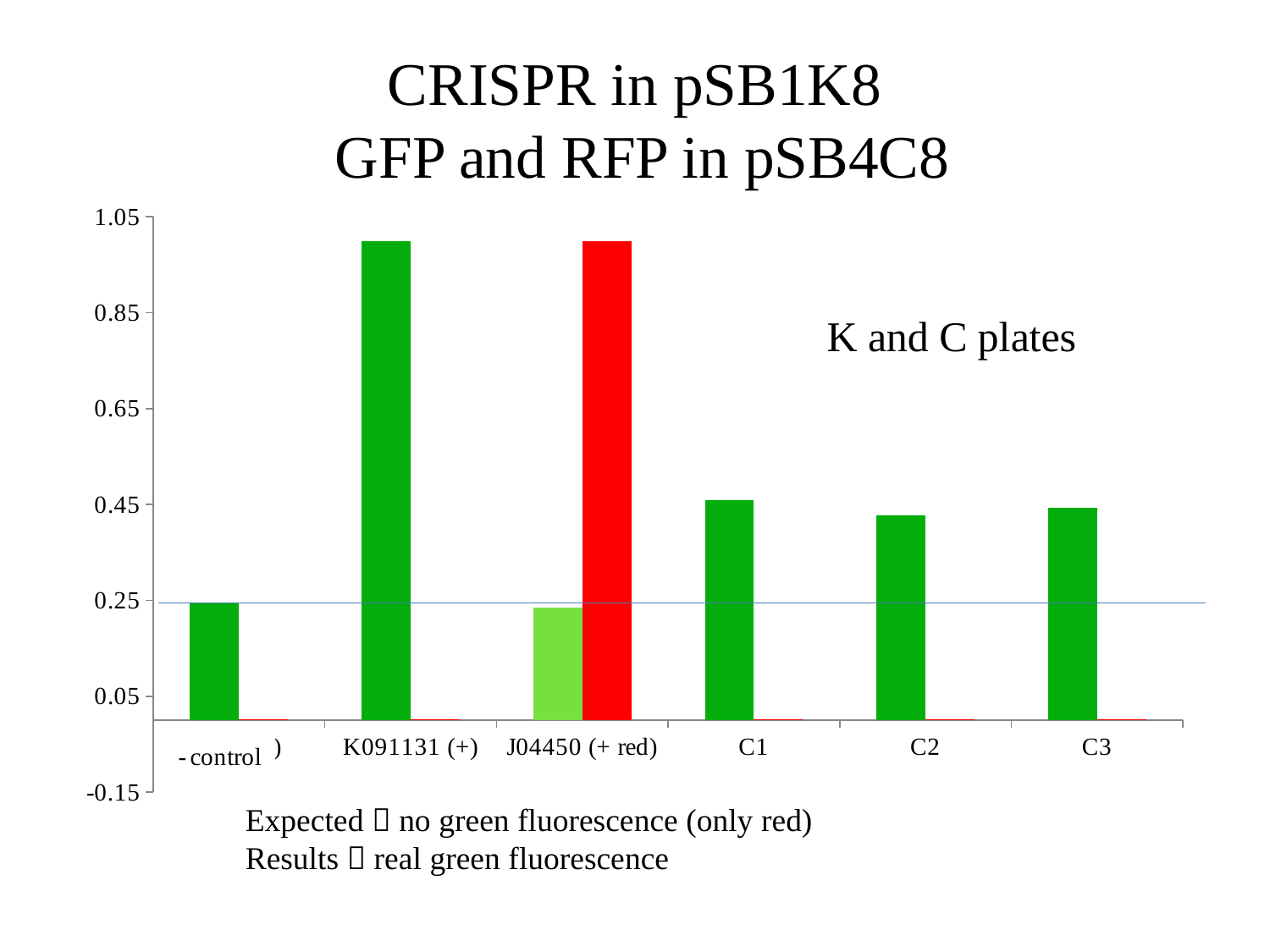
Which is larger, the green bar for - control or the green bar for C2? C2 Is the green bar for C1 greater or less than 0.25? greater Is the green bar for K091131 (+) greater or less than 0.85? greater What is the title of the chart on the slide? CRISPR in pSB1K8 GFP and RFP in pSB4C8 Is the green bar for - control greater or less than 0.45? less Which is larger, the green bar for K091131 (+) or the green bar for C1? K091131 (+) Which is larger, the red bar for J04450 (+ red) or the red bar for C1? J04450 (+ red) How many categories are shown along the x axis of the chart? 6 Which category has the tallest green bar? K091131 (+) What kind of chart is shown on the slide? bar chart